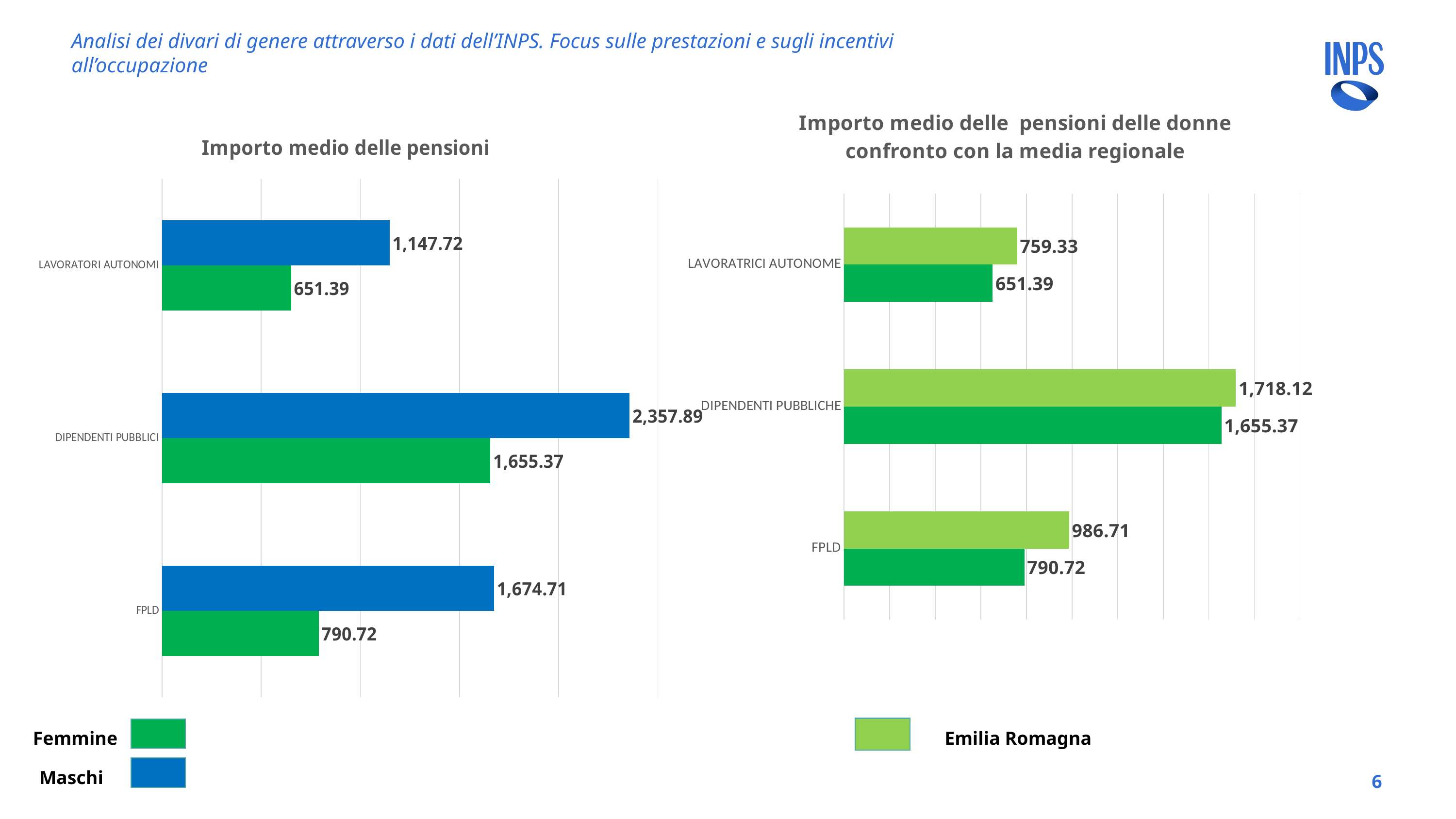
In the chart 'Importo medio delle pensioni', which category has the lowest value for Femmine? LAVORATORI AUTONOMI In the chart 'Importo medio delle pensioni', what is the value for Maschi in the DIPENDENTI PUBBLICI category? 2,357.89 In the chart 'Importo medio delle pensioni', what is the value for Femmine in the FPLD category? 790.72 In the right-hand chart 'Importo medio delle pensioni delle donne confronto con la media regionale', what is the Emilia Romagna value for FPLD? 986.71 In the chart 'Importo medio delle pensioni', how many series does the legend list? 2 In the chart 'Importo medio delle pensioni', what is the difference between the Maschi and Femmine values for FPLD? 883.99 In the right-hand chart 'Importo medio delle pensioni delle donne confronto con la media regionale', what is the difference between the Emilia Romagna value and the other value for LAVORATRICI AUTONOME? 107.94 In the chart 'Importo medio delle pensioni', what is the value for Femmine in the LAVORATORI AUTONOMI category? 651.39 What kind of chart is 'Importo medio delle pensioni'? Bar chart In the chart 'Importo medio delle pensioni', which category has the highest value for Maschi? DIPENDENTI PUBBLICI In the right-hand chart 'Importo medio delle pensioni delle donne confronto con la media regionale', what is the Emilia Romagna value for DIPENDENTI PUBBLICHE? 1,718.12 In the right-hand chart 'Importo medio delle pensioni delle donne confronto con la media regionale', how many categories are shown? 3